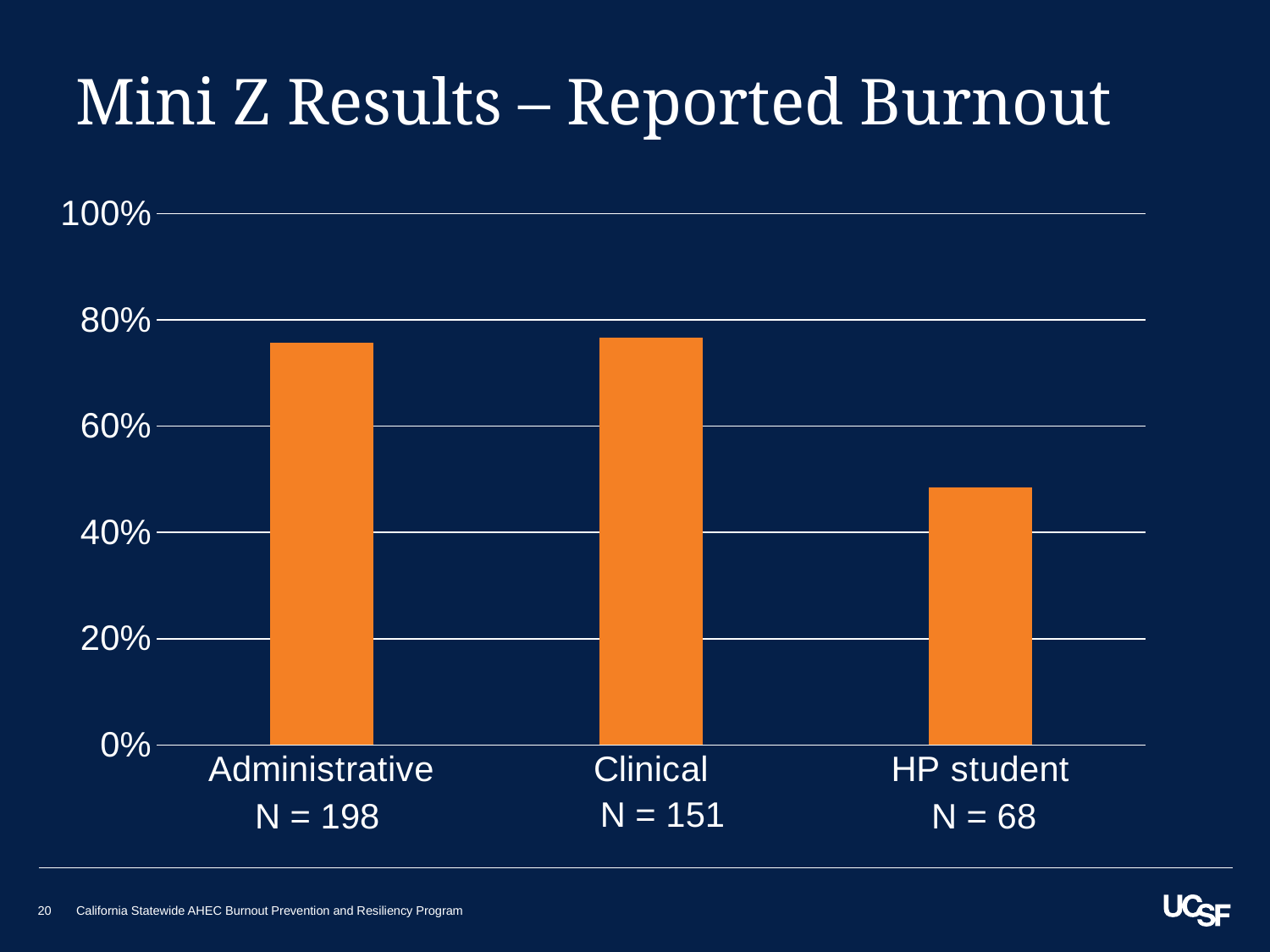
How many categories are shown on the x axis of the chart? 3 Is the value for Administrative greater or less than 60%? greater What is the title of the slide containing the chart? Mini Z Results – Reported Burnout Is the value for HP student greater or less than 60%? less What sample size (N) is shown for the Clinical category? N = 151 Is the value for Clinical greater or less than 80%? less What type of chart is shown on the slide? Bar chart Which is larger, the value for Clinical or the value for HP student? Clinical Which category has the lowest reported burnout? HP student